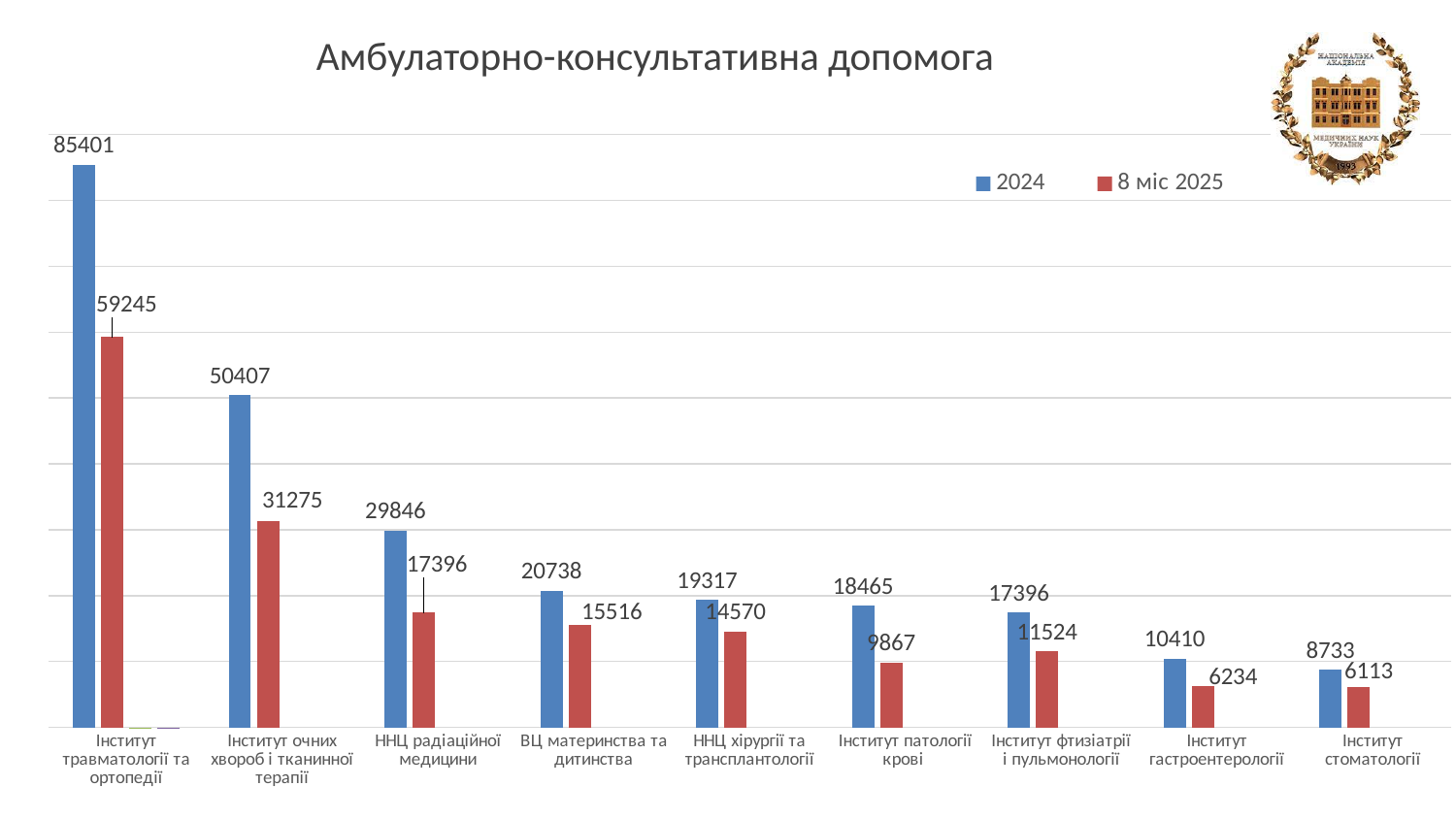
Which category has the lowest 2024 value? Інститут стоматології What is the difference between the 2024 values for Інститут гастроентерології and Інститут стоматології? 1677 What is the 8 міс 2025 value for Інститут очних хвороб і тканинної терапії? 31275 How many series does the legend list? 2 What kind of chart is shown on the slide? bar chart What is the difference between the 2024 and 8 міс 2025 values for ННЦ радіаційної медицини? 12450 Which category has the highest 8 міс 2025 value? Інститут травматології та ортопедії What is the title of the chart? Амбулаторно-консультативна допомога What is the 8 міс 2025 value for Інститут патології крові? 9867 What is the 2024 value for Інститут травматології та ортопедії? 85401 Which is larger: the 2024 value for ВЦ материнства та дитинства or the 2024 value for ННЦ хірургії та трансплантології? ВЦ материнства та дитинства How many categories are shown on the x axis? 9